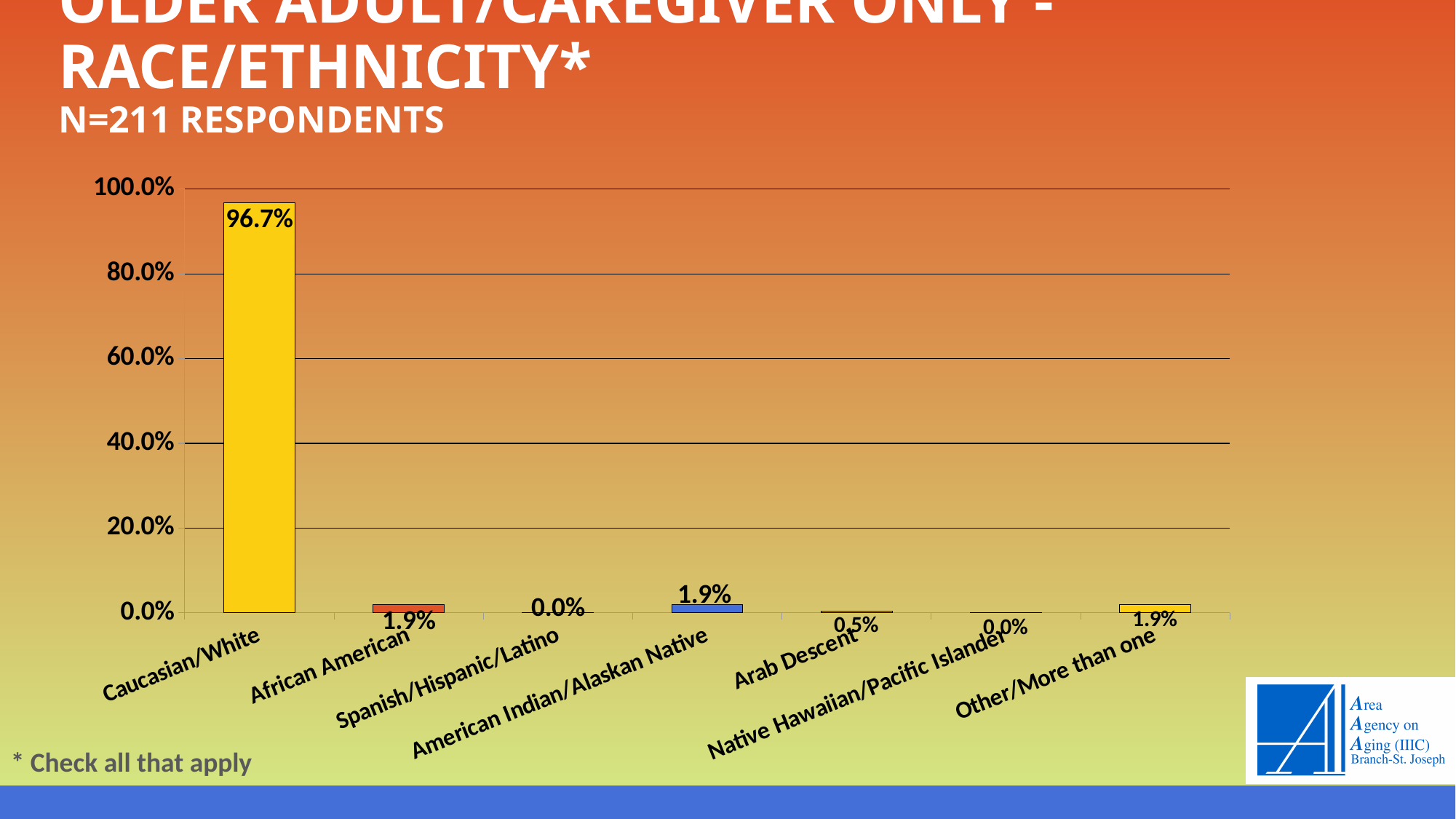
What kind of chart is shown on the slide? bar chart What is the value shown for Arab Descent? 0.5% What is the value shown for Spanish/Hispanic/Latino? 0.0% Which race/ethnicity category has the highest value? Caucasian/White What is the value shown for Other/More than one? 1.9% Which is larger, the value for Arab Descent or the value for Other/More than one? Other/More than one What is the difference between the values for American Indian/Alaskan Native and Arab Descent? 1.4% What is the difference between the values for Caucasian/White and African American? 94.8% How many race/ethnicity categories are shown on the x axis? 7 Is the value for Caucasian/White greater or less than 80.0%? greater What percentage of respondents identified as Caucasian/White? 96.7% What is the value shown for African American? 1.9%